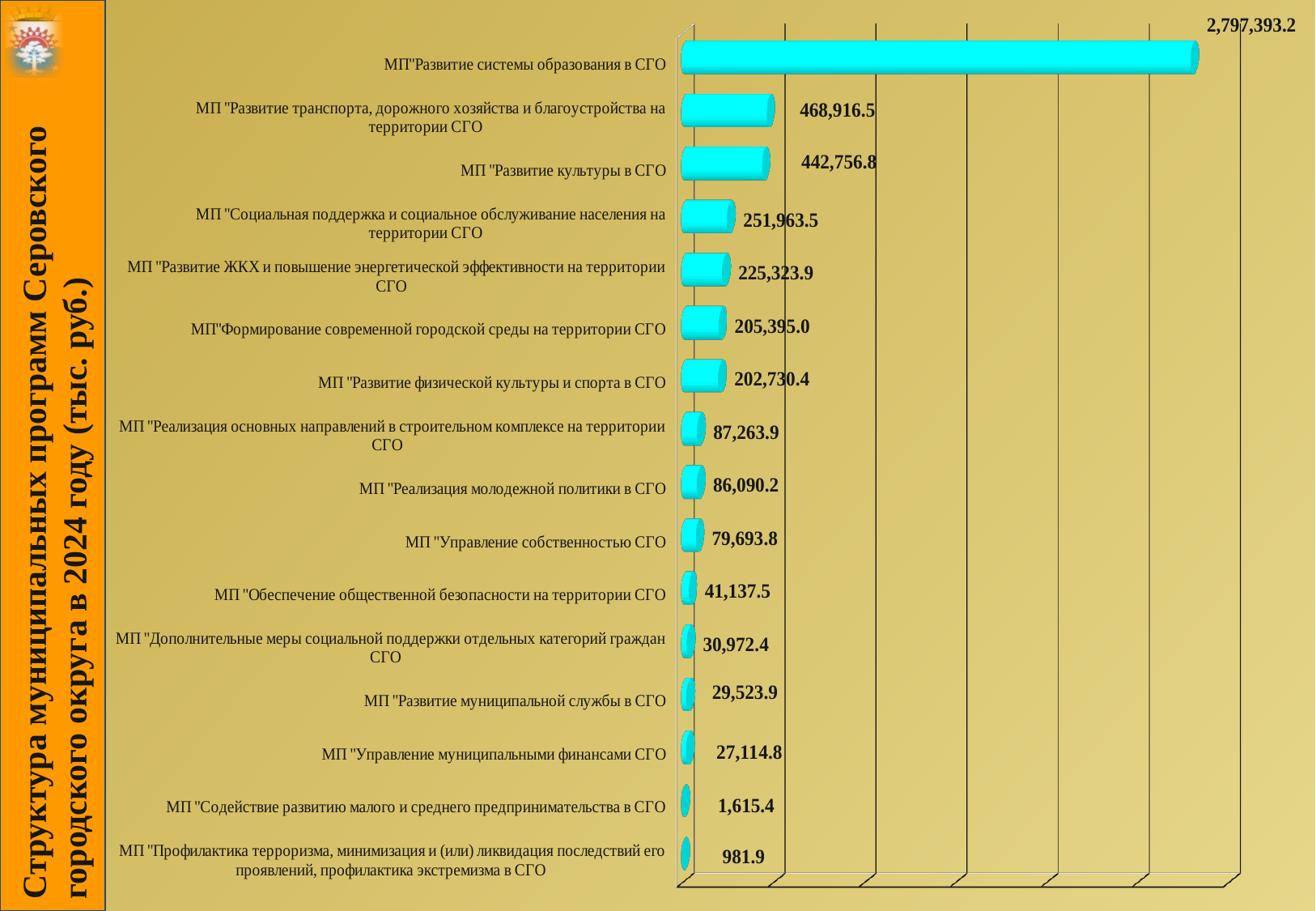
Which program has the lowest value? МП "Профилактика терроризма, минимизация и (или) ликвидация последствий его проявлений, профилактика экстремизма в СГО" In what units are the values in the chart expressed, according to the slide title? тыс. руб. What is the difference between the values for МП "Развитие транспорта, дорожного хозяйства и благоустройства на территории СГО" and МП "Развитие культуры в СГО"? 26,159.7 What type of chart is shown on the slide? Bar chart What is the value for МП "Управление собственностью СГО"? 79,693.8 Which program has the highest value? МП "Развитие системы образования в СГО" What is the value for МП "Развитие культуры в СГО"? 442,756.8 Which is larger: the value for МП "Обеспечение общественной безопасности на территории СГО" or МП "Развитие муниципальной службы в СГО"? МП "Обеспечение общественной безопасности на территории СГО" How many programs (categories) are shown in the chart? 16 What is the difference between the values for МП "Развитие системы образования в СГО" and МП "Развитие транспорта, дорожного хозяйства и благоустройства на территории СГО"? 2,328,476.7 What is the value for МП "Развитие физической культуры и спорта в СГО"? 202,730.4 What is the value for МП "Содействие развитию малого и среднего предпринимательства в СГО"? 1,615.4